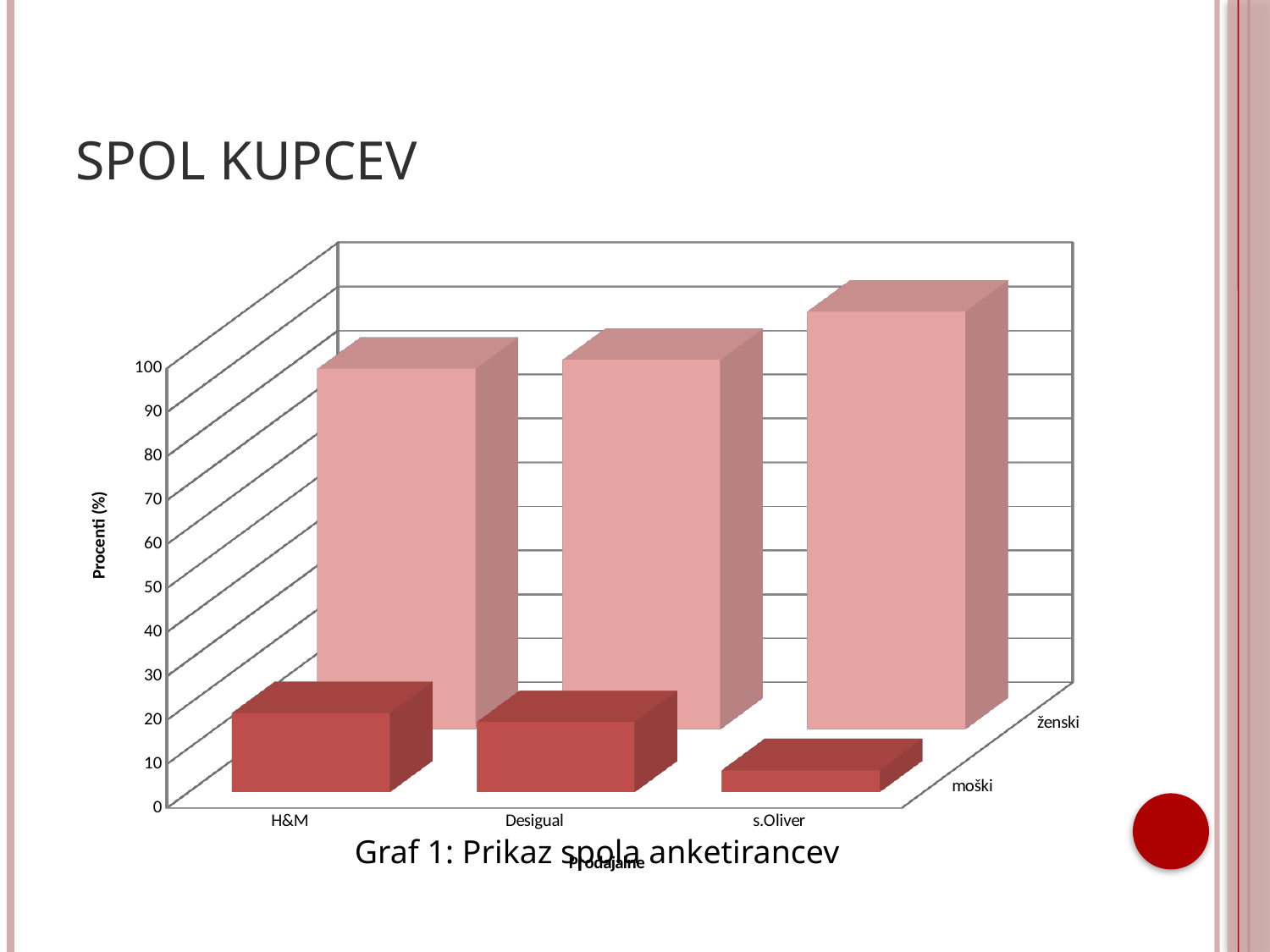
What is the label of the vertical axis of the chart? Procenti (%) Which store has the highest value for the ženski series? s.Oliver Is the ženski value for H&M greater or less than 50? greater How many stores (categories) are shown on the x axis of the chart? 3 Which store has the lowest value for the moški series? s.Oliver For s.Oliver, which series has the larger value, moški or ženski? ženski What kind of chart is shown on the slide? bar chart Is the moški value for s.Oliver greater or less than 10? less Which store has the highest value for the moški series? H&M Do the moški values rise or fall from H&M to s.Oliver along the x axis? fall